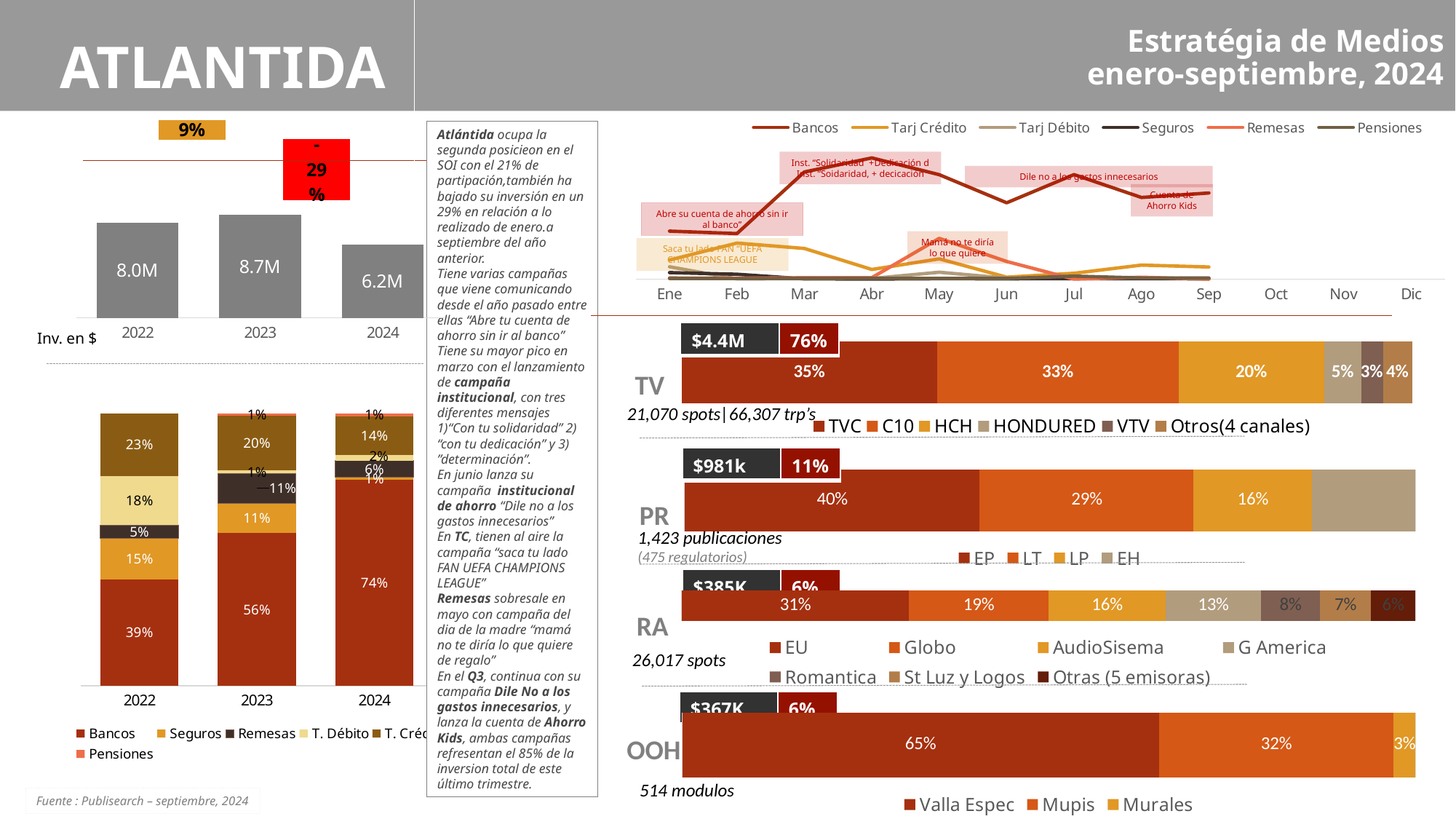
In the RA bar on the right, what is the difference between the EU share and the Globo share? 12% In the line chart at the top right, how many series does the legend list? 6 In the TV bar on the right, what is the share for C10? 33% In the PR bar on the right, which category has the largest share? EP In the stacked bar chart at the bottom left, how much larger is the Bancos share in 2023 than in 2022? 17% In the 'Inv. en $' bar chart on the left, which year has the lowest investment? 2024 In the 'Inv. en $' bar chart on the left, what is the value for 2023? 8.7M In the stacked bar chart at the bottom left, what is the share of T. Débito in 2022? 18% In the stacked bar chart at the bottom left, what is the share of Bancos in 2024? 74% In the 'Inv. en $' bar chart on the left, how many years are shown? 3 In the line chart at the top right, what kind of chart is it? line chart In the OOH bar on the right, which is larger, Valla Espec or Mupis? Valla Espec